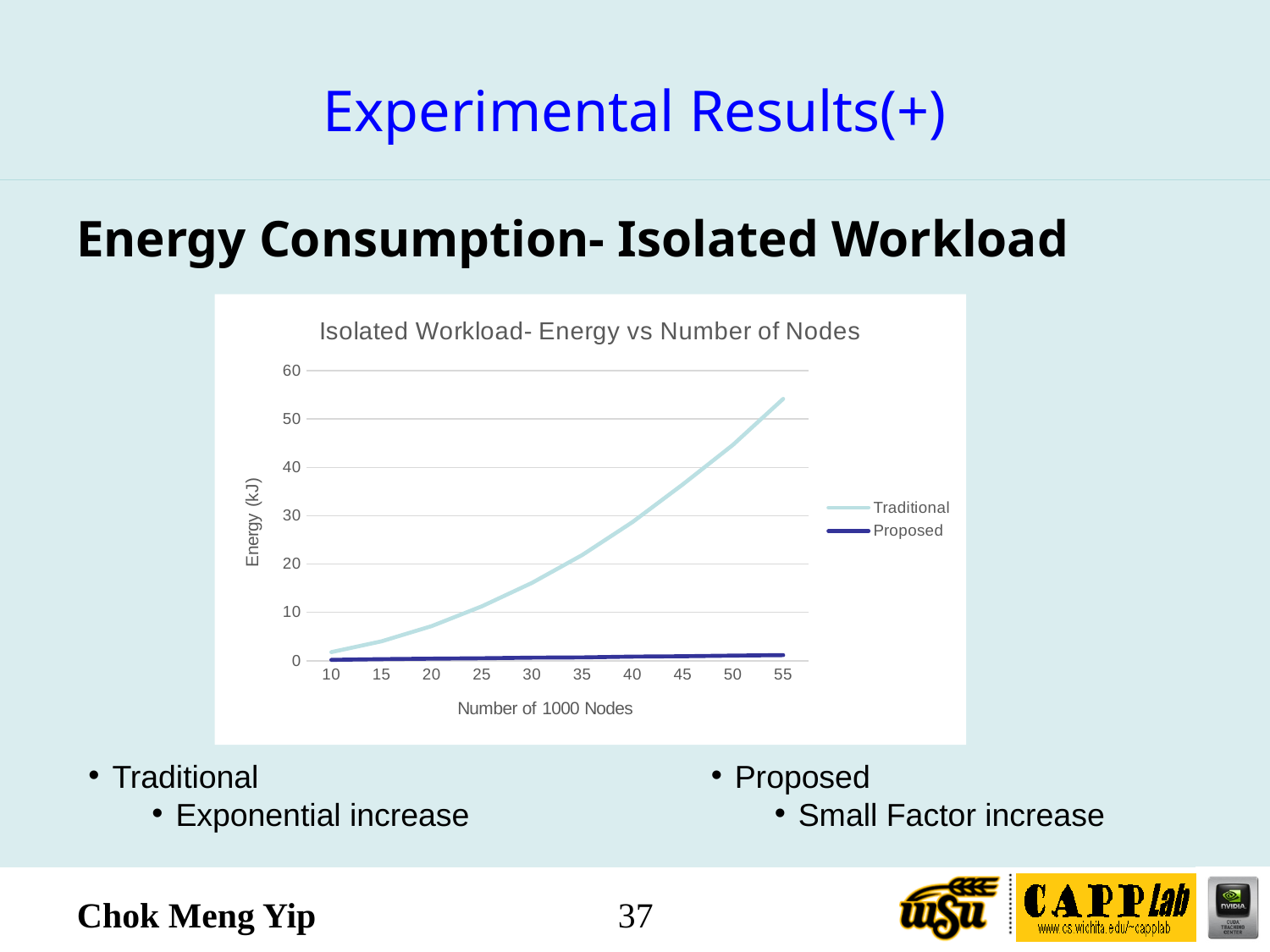
Which series has the lowest energy value across the whole chart? Proposed Does the Traditional series rise or fall as the number of nodes increases? Rises Is the Traditional value at 30 greater or less than 20? less At 55 (thousand nodes), which series has the higher energy value, Traditional or Proposed? Traditional Which two series are listed in the chart legend? Traditional and Proposed How many tick values are shown along the x axis? 10 Is the Proposed value at 55 greater or less than 10? less Is the Traditional value at 55 greater or less than 50? greater How many series does the legend list? 2 What kind of chart is shown on the slide? Line chart What is the title of the chart? Isolated Workload- Energy vs Number of Nodes